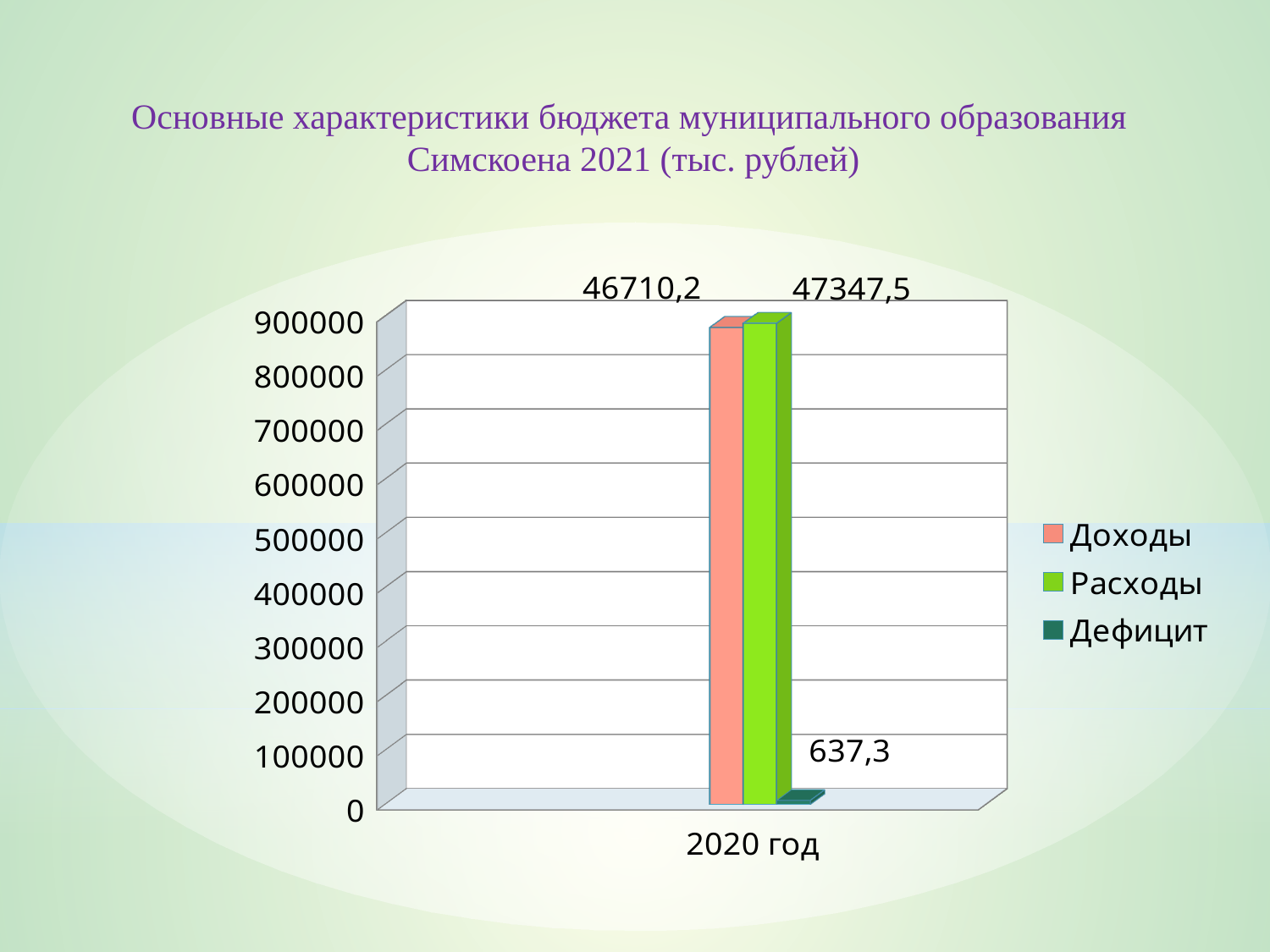
What kind of chart is shown on the slide? bar chart Which series has the highest value for 2020 год? Расходы Which colour represents Расходы in the legend? green What is the difference between Расходы and Доходы for 2020 год? 637,3 Which is larger for 2020 год, Доходы or Расходы? Расходы What is the value of Дефицит for 2020 год? 637,3 Which series has the lowest value for 2020 год? Дефицит What is the value of Расходы for 2020 год? 47347,5 How many series does the legend list? 3 How many categories are shown on the x axis? 1 What is the category label on the x axis? 2020 год What is the value of Доходы for 2020 год? 46710,2